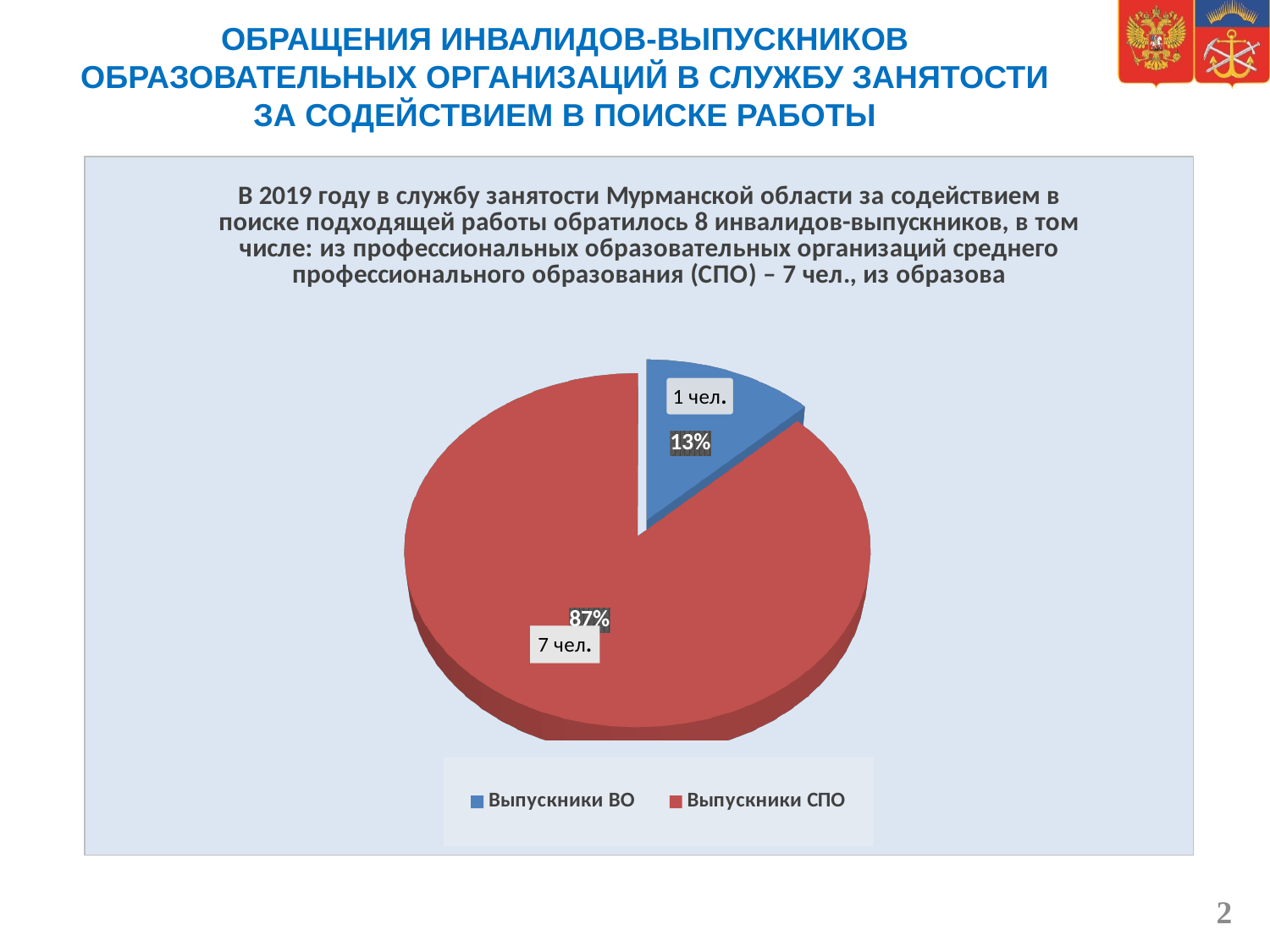
What share of the pie does Выпускники ВО take? 13% Which is larger, Выпускники ВО or Выпускники СПО? Выпускники СПО What is the difference in people between Выпускники СПО and Выпускники ВО? 6 чел. What kind of chart is shown on the slide? pie chart What is the value for Выпускники ВО? 1 чел. What share of the pie does Выпускники СПО take? 87% How many slices does the pie chart have? 2 Which category has the smallest slice? Выпускники ВО How many series does the legend list? 2 Which category has the largest slice? Выпускники СПО What is the value for Выпускники СПО? 7 чел. What colour is the slice for Выпускники ВО? blue